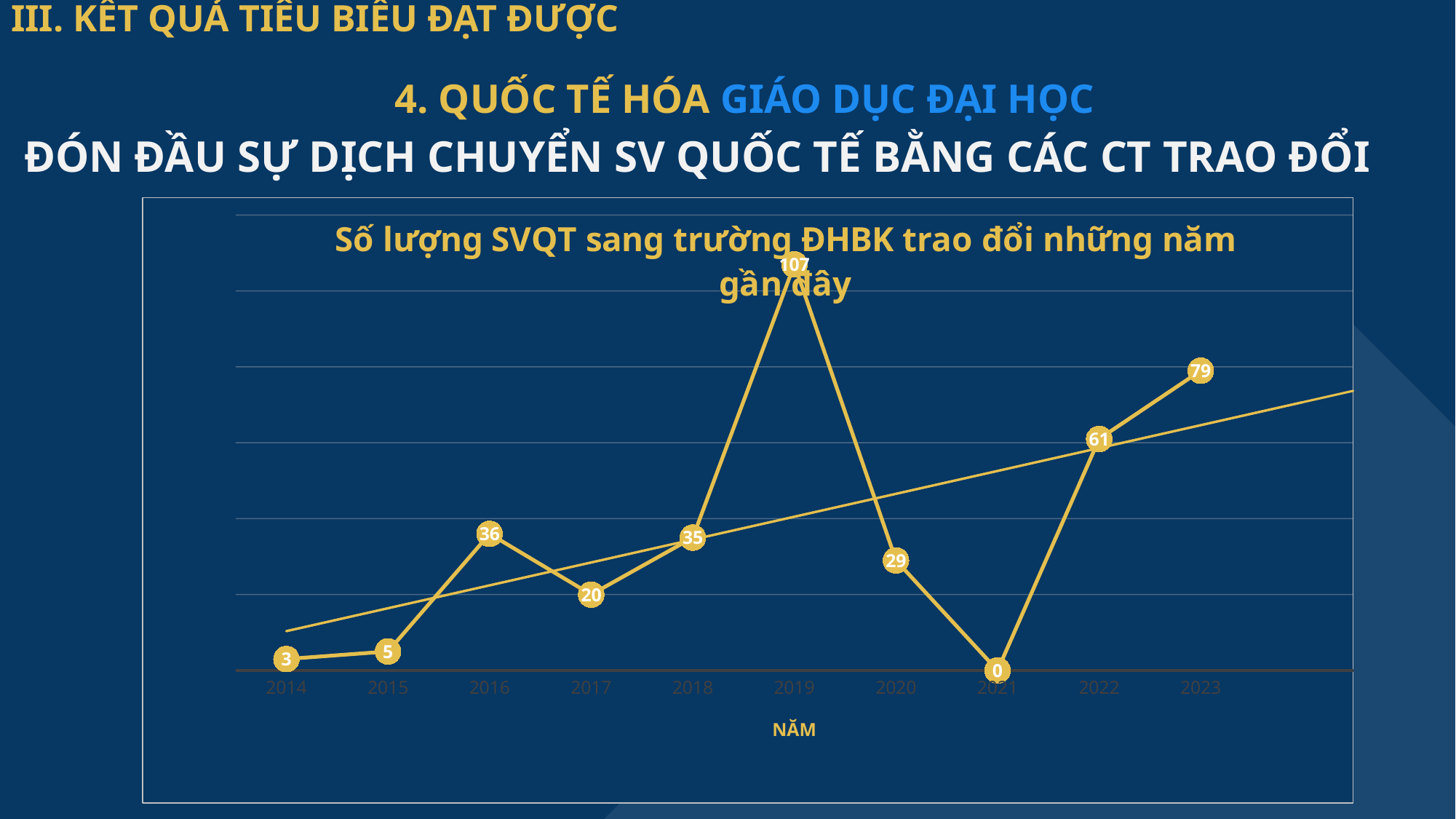
What is the value for 2016? 36 What is the title of the x axis? NĂM What is the value for 2022? 61 Which year has the lowest value? 2021 How many years are plotted on the x axis? 10 What is the difference between the values for 2019 and 2020? 78 What is the value for 2019? 107 What is the value for 2021? 0 Which is larger, the value for 2016 or the value for 2018? 2016 Which year has the highest value? 2019 What is the difference between the values for 2023 and 2022? 18 What kind of chart is this? line chart